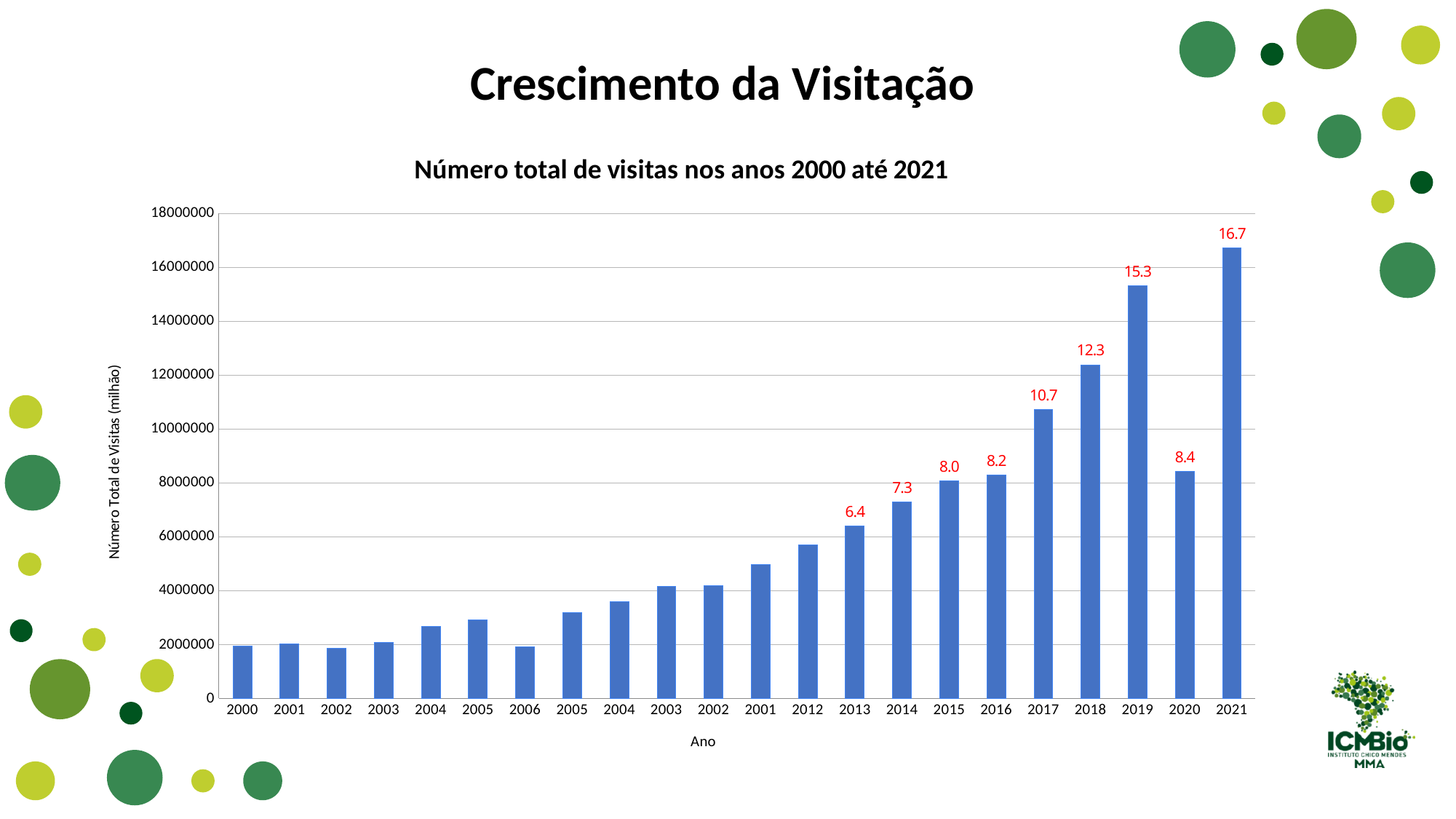
How many bars are plotted in the chart? 22 What is the data label shown for 2013? 6.4 What is the data label shown for 2021? 16.7 What kind of chart is shown on the slide? Bar chart Which is larger, the value for 2016 or the value for 2015? 2016 What is the data label shown for 2019? 15.3 What is the difference between the labelled values for 2021 and 2019? 1.4 Which year has the highest number of visits? 2021 What is the data label shown for 2020? 8.4 Is the value for 2012 greater or less than 6000000? less Do the values rise or fall from 2017 to 2019? Rise What is the difference between the labelled values for 2019 and 2020? 6.9